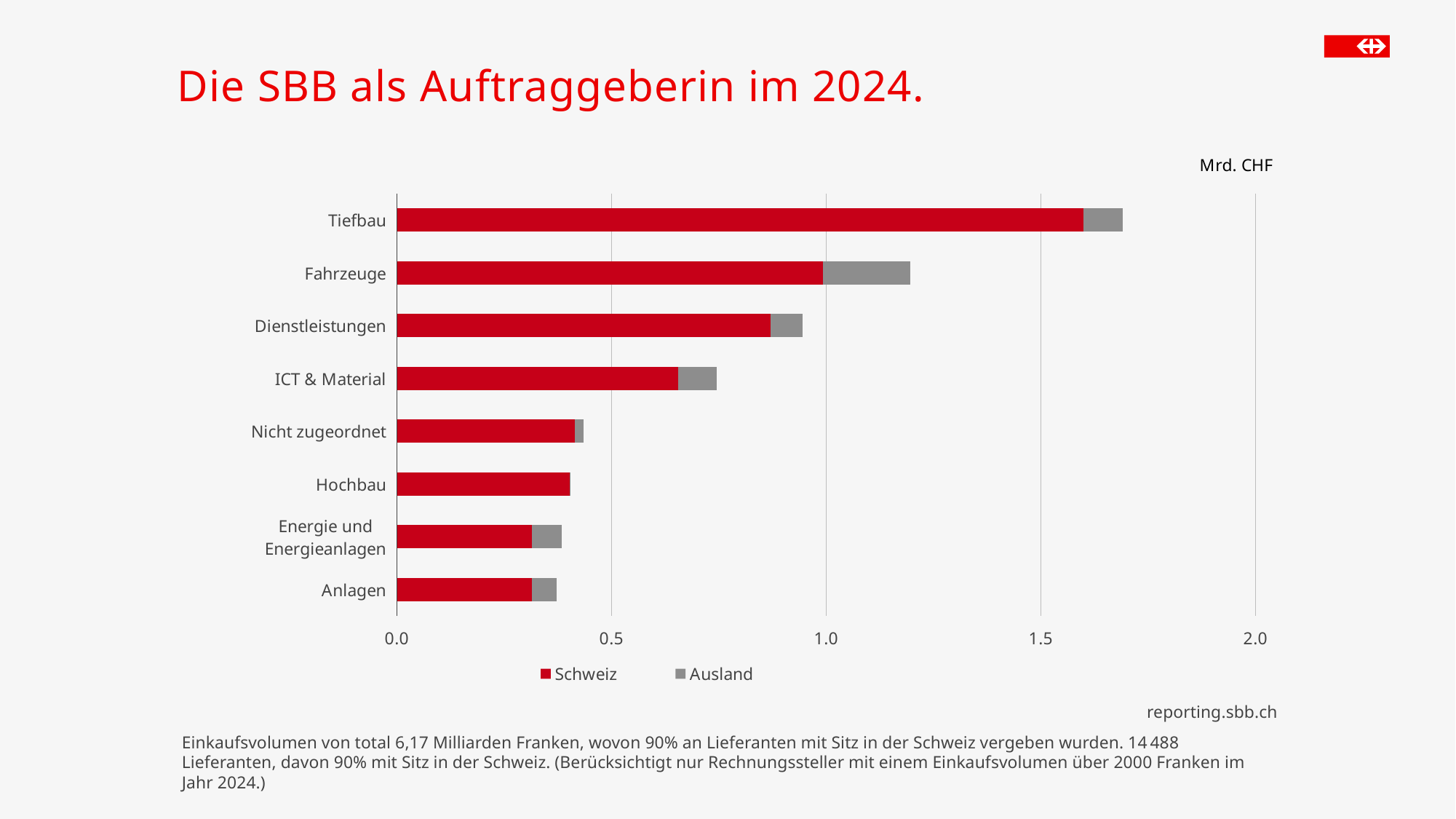
What kind of chart is shown on the slide? bar chart What unit is shown for the values on the chart? Mrd. CHF Which series is shown in grey in the legend? Ausland Is the total value for Fahrzeuge greater or less than 1.0? greater How many series does the legend list? 2 Which category has the highest total value? Tiefbau Is the total value for Dienstleistungen greater or less than 1.0? less Which has a larger total value, Dienstleistungen or ICT & Material? Dienstleistungen Is the total value for ICT & Material greater or less than 0.5? greater How many categories are shown on the chart? 8